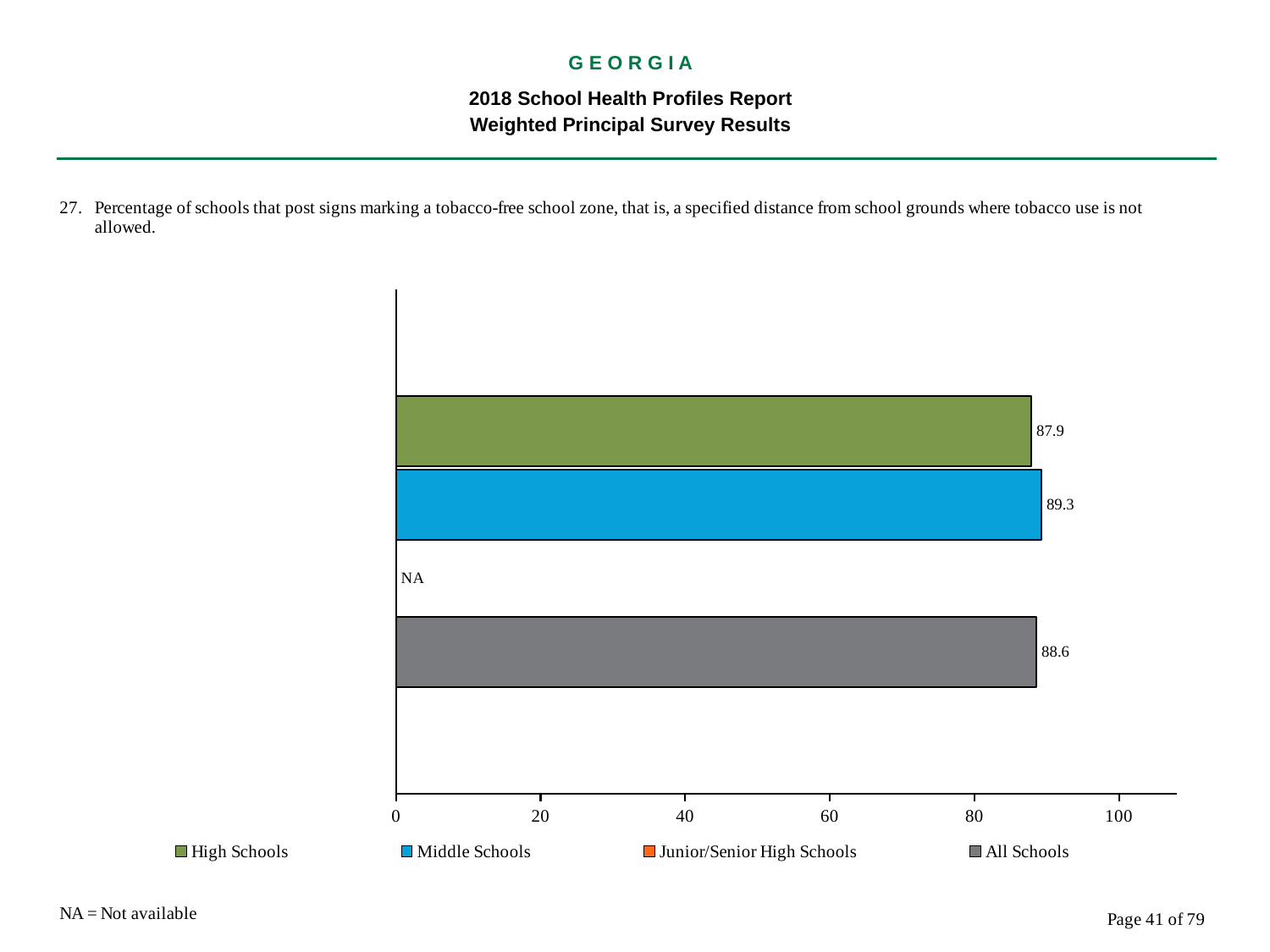
What is the difference between the Middle Schools value and the High Schools value? 1.4 What is the value for Middle Schools? 89.3 How many series does the legend list? 4 Which school type with a plotted value has the lowest value? High Schools Which school type has the highest value? Middle Schools What is the value for All Schools? 88.6 What is shown for Junior/Senior High Schools? NA What is the difference between the All Schools value and the High Schools value? 0.7 What kind of chart is this? bar chart What is the value for High Schools? 87.9 What colour is the bar for All Schools? gray Is the value for Middle Schools greater or less than 80? greater